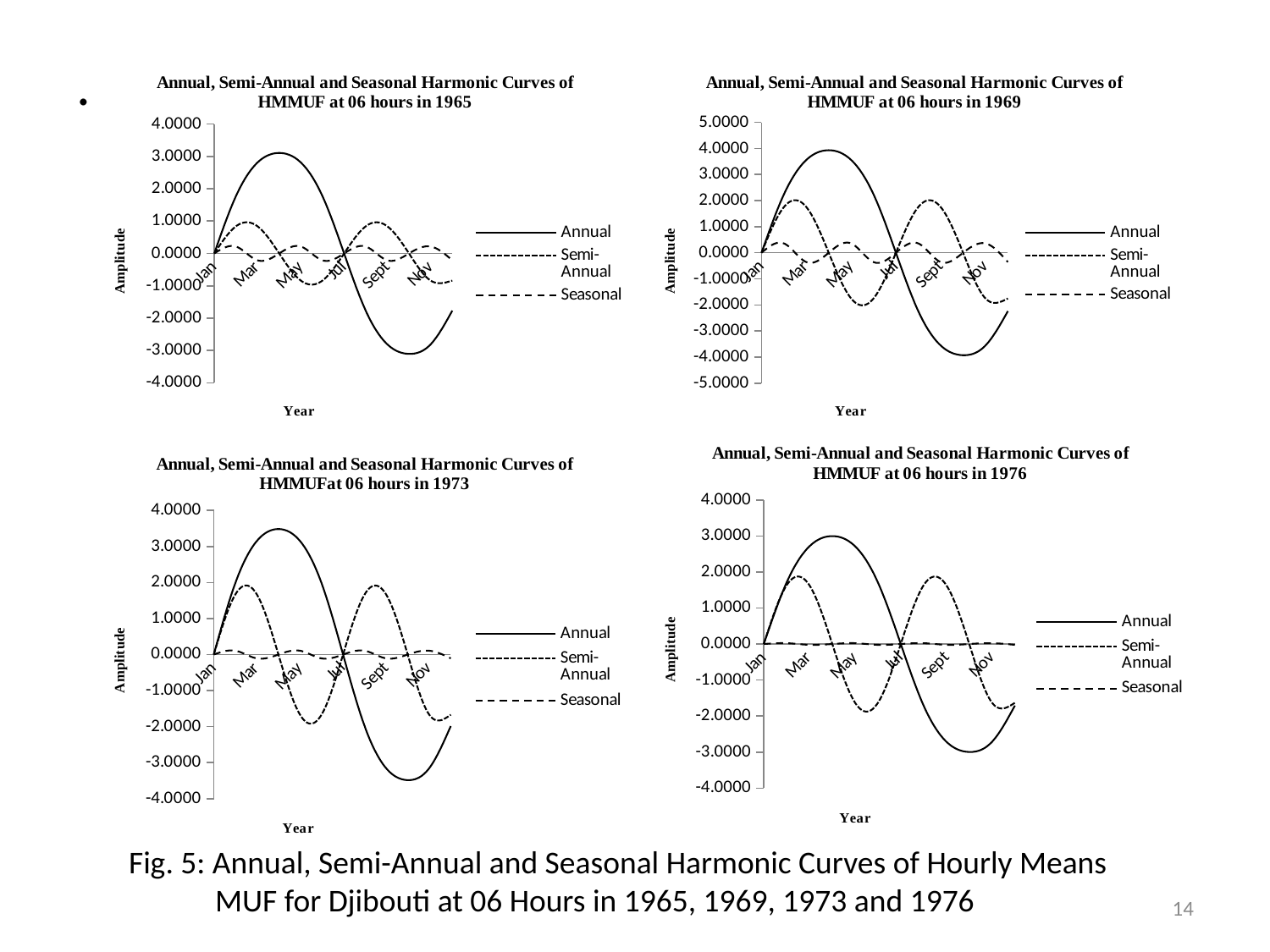
In the bottom-left chart (HMMUF at 06 hours in 1973), what are the three series named in the legend? Annual, Semi-Annual, Seasonal How many series does the legend list in the top-right chart (HMMUF at 06 hours in 1969)? 3 How many month labels are shown on the x axis of the bottom-left chart (HMMUF at 06 hours in 1973)? 6 In the top-left chart (HMMUF at 06 hours in 1965), which curve reaches a higher peak, Annual or Semi-Annual? Annual What is the highest value shown on the y axis of the top-right chart (HMMUF at 06 hours in 1969)? 5.0000 In the bottom-right chart (HMMUF at 06 hours in 1976), is the peak value of the Semi-Annual curve greater or less than 1.0000? greater What kind of chart is the top-left chart (HMMUF at 06 hours in 1965)? line chart In the bottom-right chart (HMMUF at 06 hours in 1976), which curve reaches a higher peak, Semi-Annual or Seasonal? Semi-Annual In the top-left chart (HMMUF at 06 hours in 1965), is the minimum value of the Annual curve greater or less than -2.0000? less In the top-right chart (HMMUF at 06 hours in 1969), is the peak value of the Annual curve greater or less than 3.0000? greater In the top-right chart (HMMUF at 06 hours in 1969), does the Annual curve rise or fall between May and Sept? fall